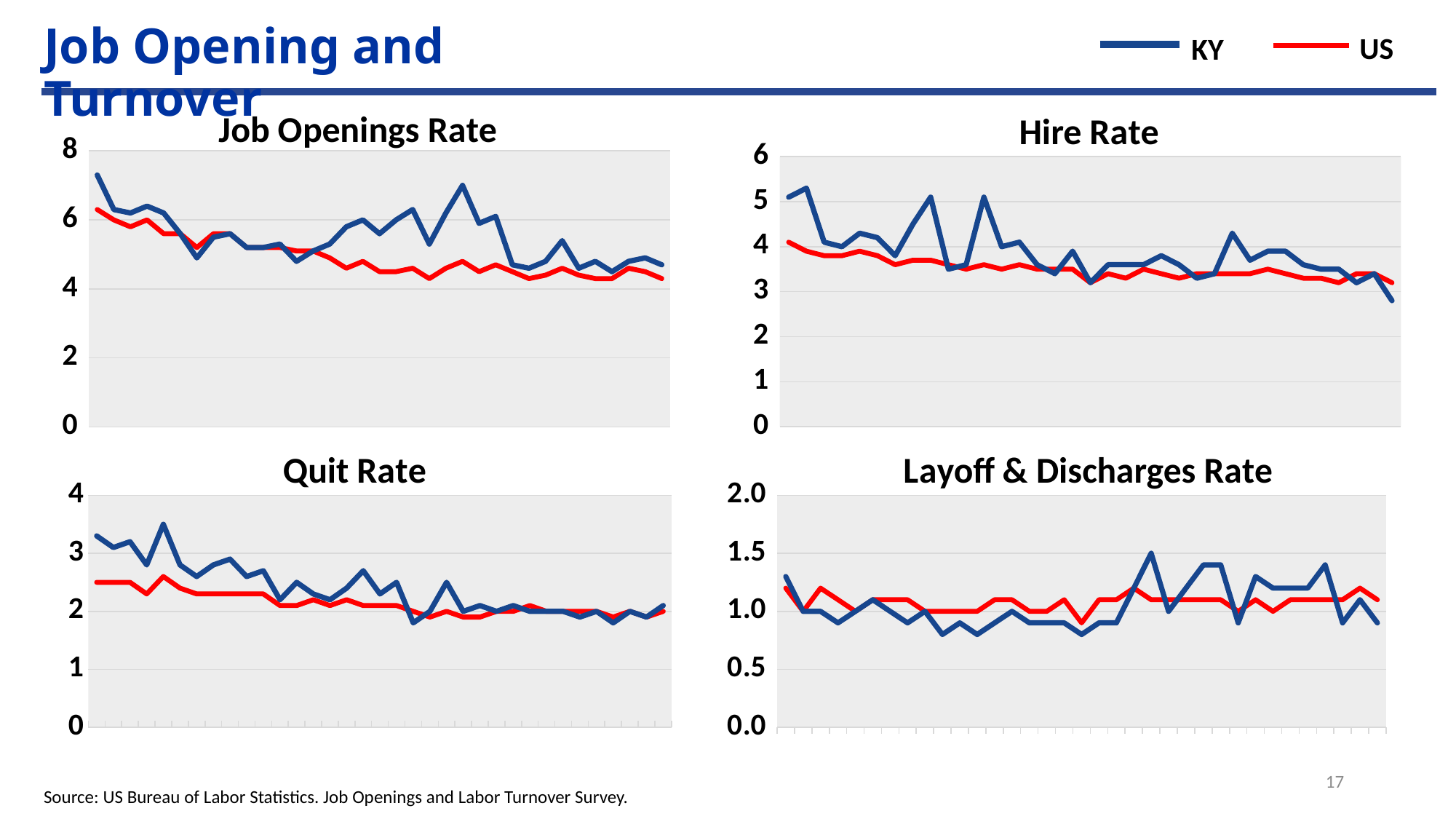
Which colour is used for the KY series? blue How many charts are shown on the slide? 4 In the Job Openings Rate chart, is the first KY value greater or less than 6? greater What is the title of the bottom-right chart? Layoff & Discharges Rate In the Quit Rate chart, does the US line generally rise or fall from left to right? fall In the Job Openings Rate chart, which series is higher at the leftmost point, KY or US? KY How many series does the legend at the top of the slide list? 2 In the Hire Rate chart, does the US line generally rise or fall from left to right? fall What kind of chart is the Job Openings Rate chart? line chart In the Quit Rate chart, is the highest KY value greater or less than 3? greater In the Hire Rate chart, is the last KY value greater or less than 3? less In the Job Openings Rate chart, does the KY line generally rise or fall from left to right? fall